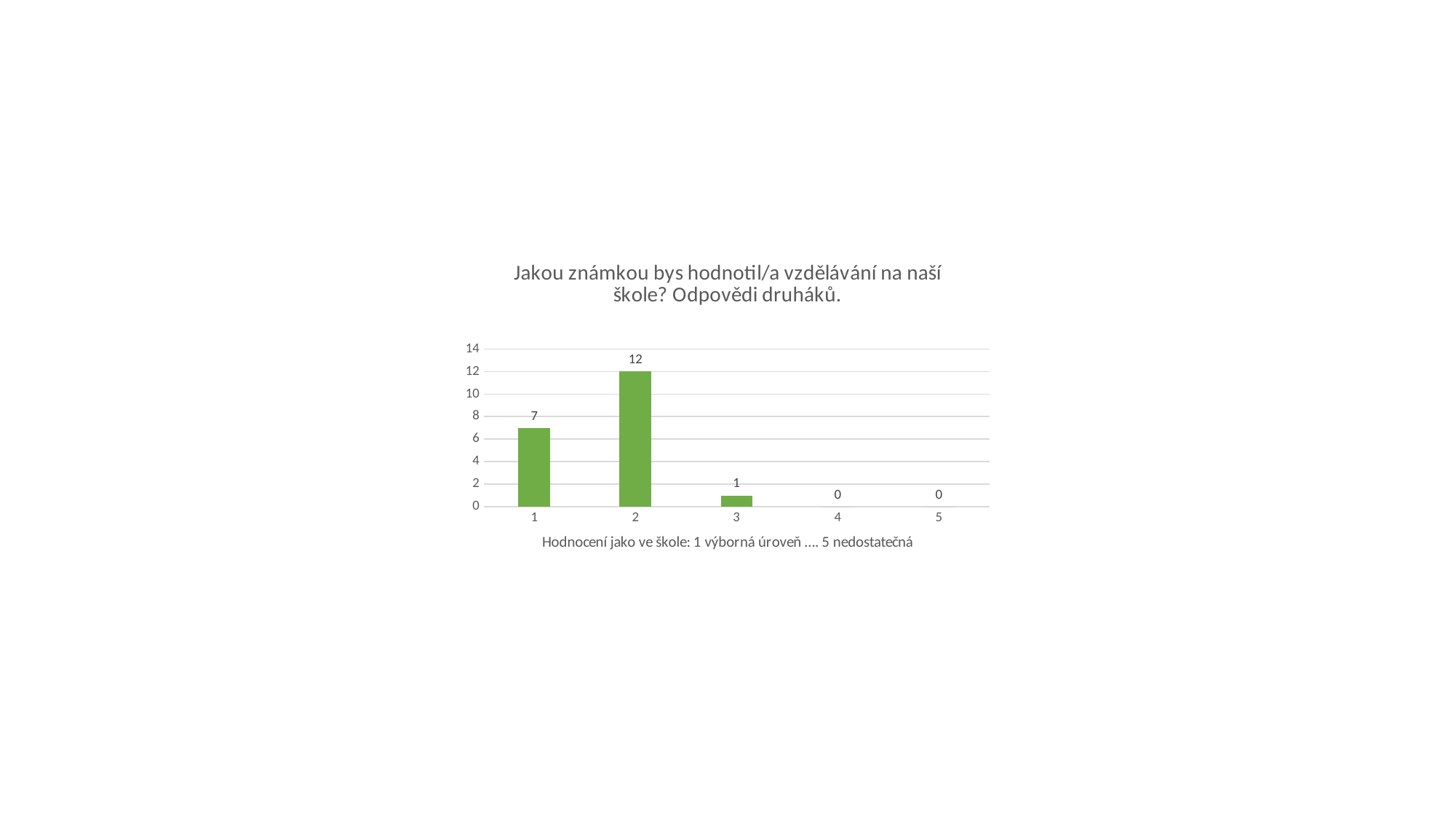
How many categories are shown on the x axis? 5 What kind of chart is shown on the slide? bar chart Which grade has the highest value? 2 What is the total of all the values shown in the chart? 20 What is the value for grade 1? 7 What is the value for grade 2? 12 Which is larger, the value for grade 1 or the value for grade 3? grade 1 What is the value for grade 3? 1 What is the value for grade 5? 0 What is the x-axis label of the chart? Hodnocení jako ve škole: 1 výborná úroveň …. 5 nedostatečná What is the difference between the values for grade 2 and grade 1? 5 Is the value for grade 2 greater or less than 10? greater